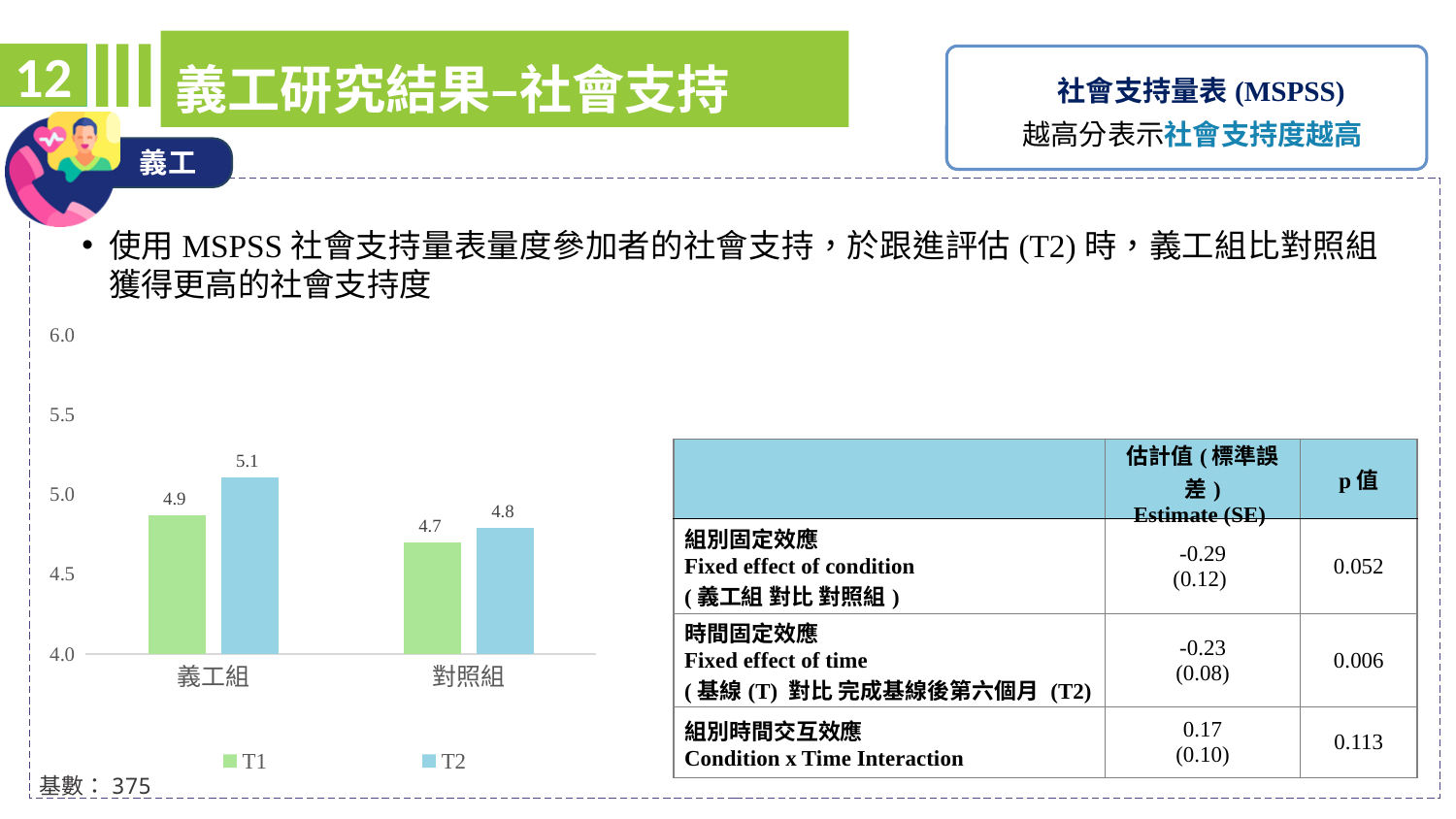
What is the difference between the T1 values of 義工組 and 對照組? 0.2 What is the T1 value for 義工組? 4.9 Which is larger, the T2 value for 義工組 or the T2 value for 對照組? 義工組 Which group has the highest T2 value? 義工組 Which bar in the chart has the lowest value? 對照組 T1 What is the T2 value for 對照組? 4.8 What is the difference between the T2 and T1 values for 義工組? 0.2 Is the T2 value for 義工組 greater or less than 5.0? greater How many series does the legend list? 2 What is the T1 value for 對照組? 4.7 What is the T2 value for 義工組? 5.1 What kind of chart is shown on the slide? bar chart